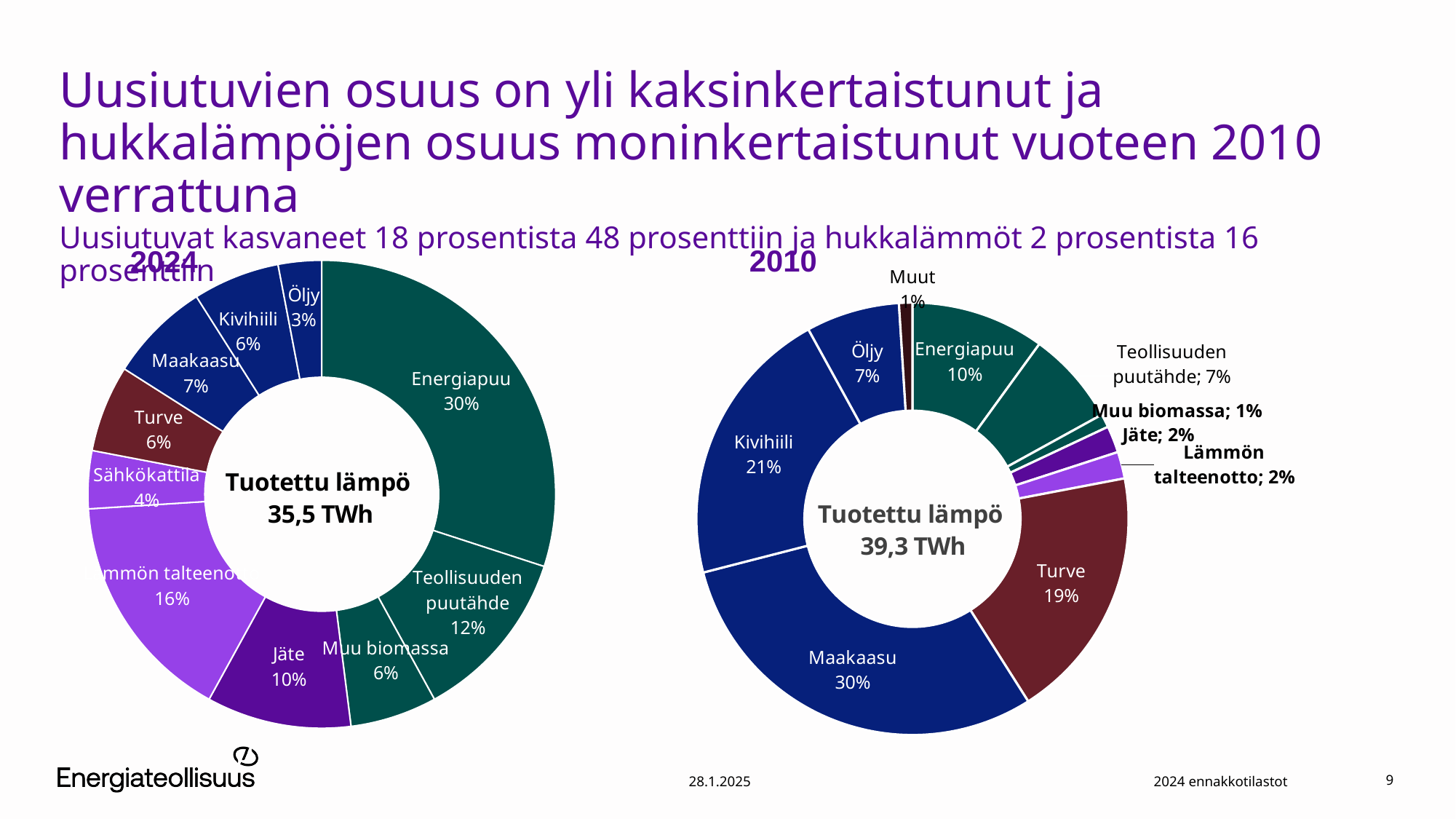
In the 2024 chart, which category has the smallest share? Öljy In the 2010 chart, what share does Turve have? 19% How many categories are shown in the 2024 chart? 10 What is the difference between the Kivihiili share in the 2010 chart and the Kivihiili share in the 2024 chart? 15 percentage points In the 2010 chart, which is larger: the share of Kivihiili or the share of Turve? Kivihiili In the 2024 chart, which category has the largest share? Energiapuu In the 2024 chart, what share does Lämmön talteenotto have? 16% In the 2010 chart, which category has the largest share? Maakaasu In the 2024 chart, what share does Energiapuu have? 30% What total produced heat is shown in the centre of the 2010 chart? 39,3 TWh In the 2010 chart, what share does Maakaasu have? 30% What type of chart is used for the 2024 data? Doughnut (pie) chart